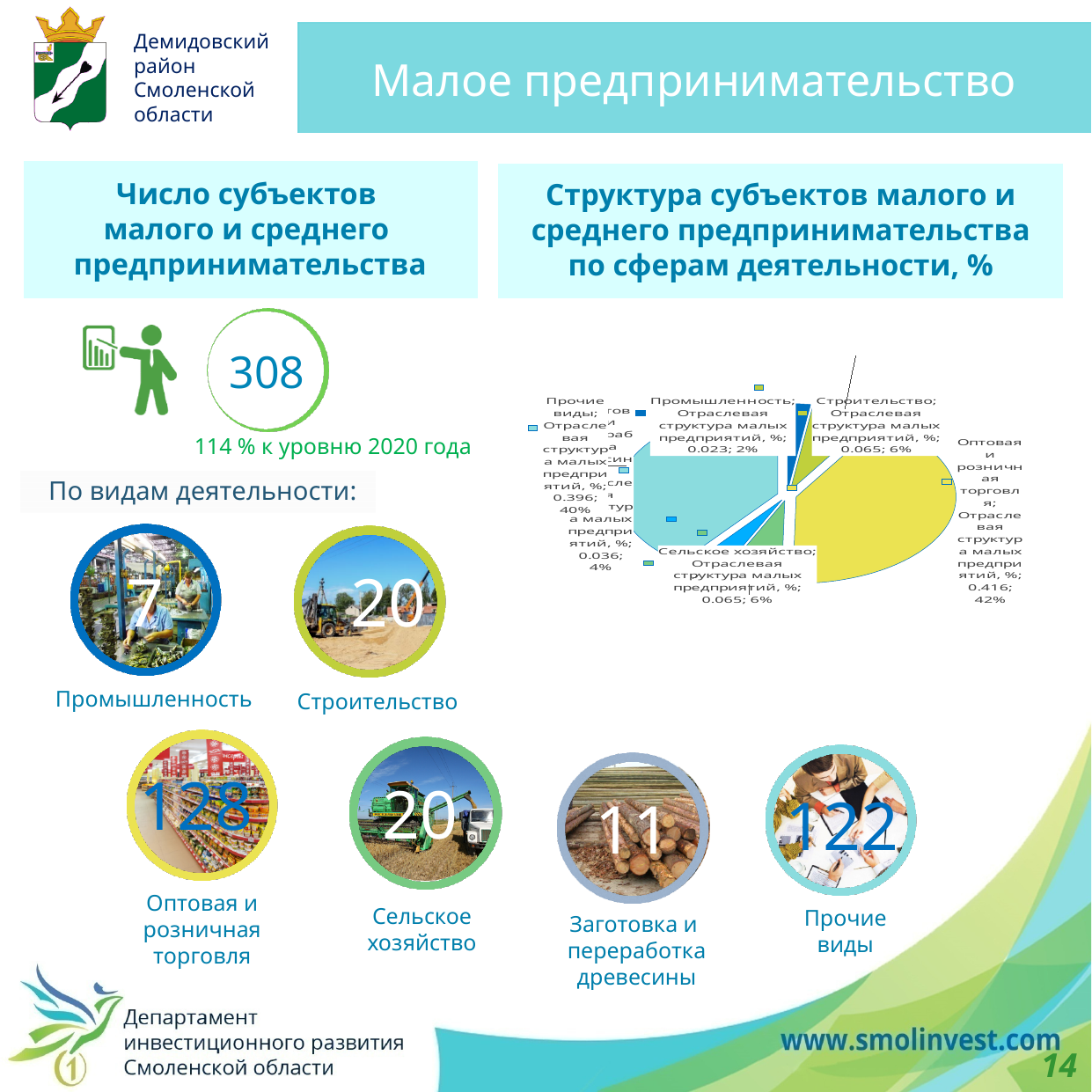
Which sector has the largest slice in the pie chart? Оптовая и розничная торговля How many slices does the pie chart have? 6 In the pie chart, what percentage share is shown for "Строительство"? 6% In the pie chart, what percentage share is shown for "Прочие виды"? 40% In the pie chart, what percentage share is shown for "Сельское хозяйство"? 6% In the pie chart, what percentage share is shown for "Промышленность"? 2% Which sector has the smallest slice in the pie chart? Промышленность In the pie chart, by how many percentage points does the share of "Прочие виды" exceed the share of "Строительство"? 34 In the pie chart, what fractional value is printed for "Оптовая и розничная торговля"? 0.416 In the pie chart, what percentage share is shown for "Оптовая и розничная торговля"? 42% In the pie chart, which has the larger share: "Прочие виды" or "Оптовая и розничная торговля"? Оптовая и розничная торговля What kind of chart is shown under the heading "Структура субъектов малого и среднего предпринимательства по сферам деятельности, %"? pie chart